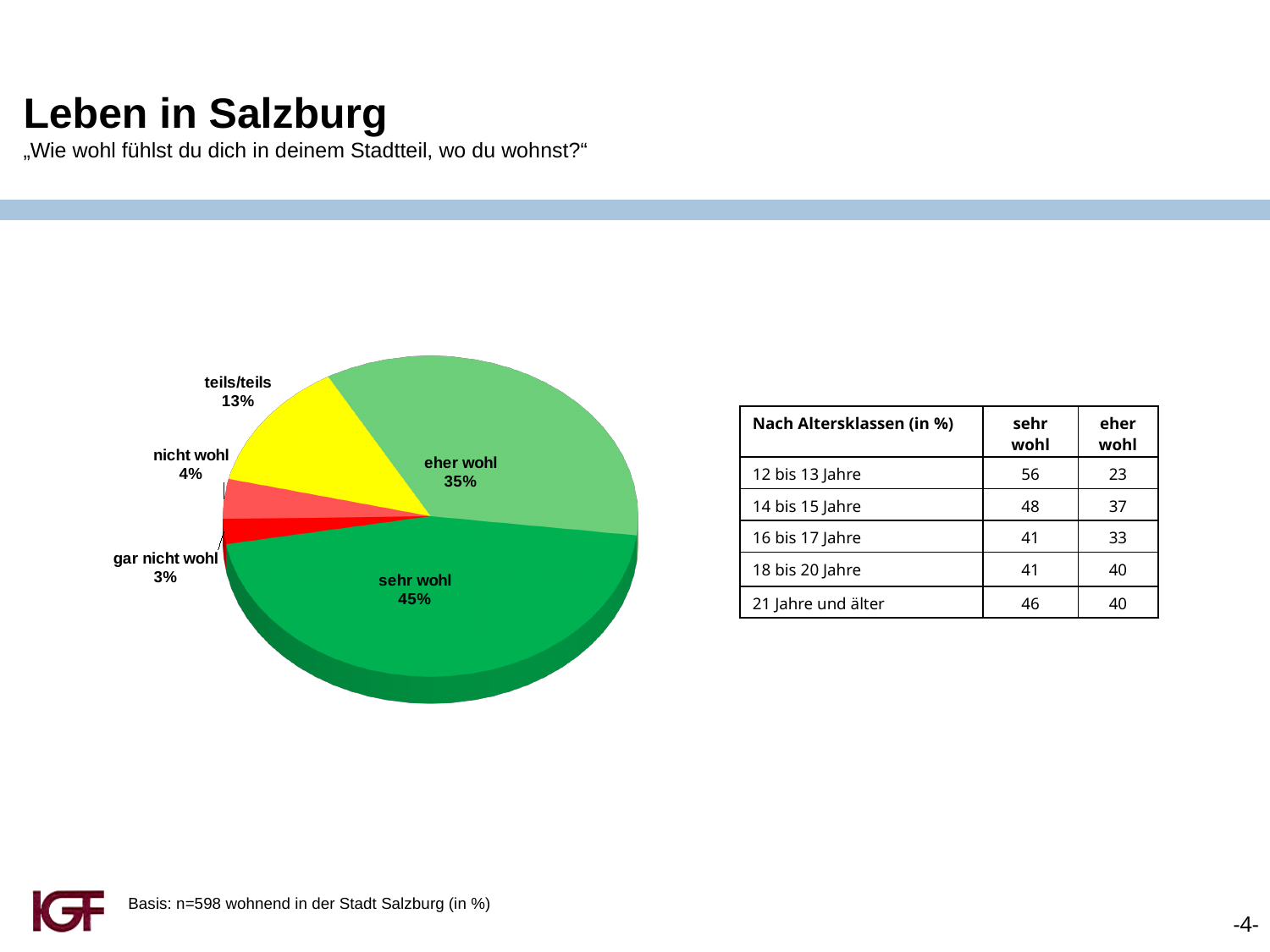
What colour is the "teils/teils" slice? yellow What percentage of respondents answered "teils/teils"? 13% What percentage of respondents answered "sehr wohl"? 45% How many slices does the pie chart have? 5 What percentage of respondents answered "gar nicht wohl"? 3% What is the combined share of "sehr wohl" and "eher wohl"? 80% What type of chart is shown on the slide? pie chart Which response category has the smallest share of the pie? gar nicht wohl What percentage of respondents answered "eher wohl"? 35% What is the difference in percentage points between "sehr wohl" and "eher wohl"? 10 Which response category has the largest share of the pie? sehr wohl Which is larger: the share for "nicht wohl" or the share for "teils/teils"? teils/teils